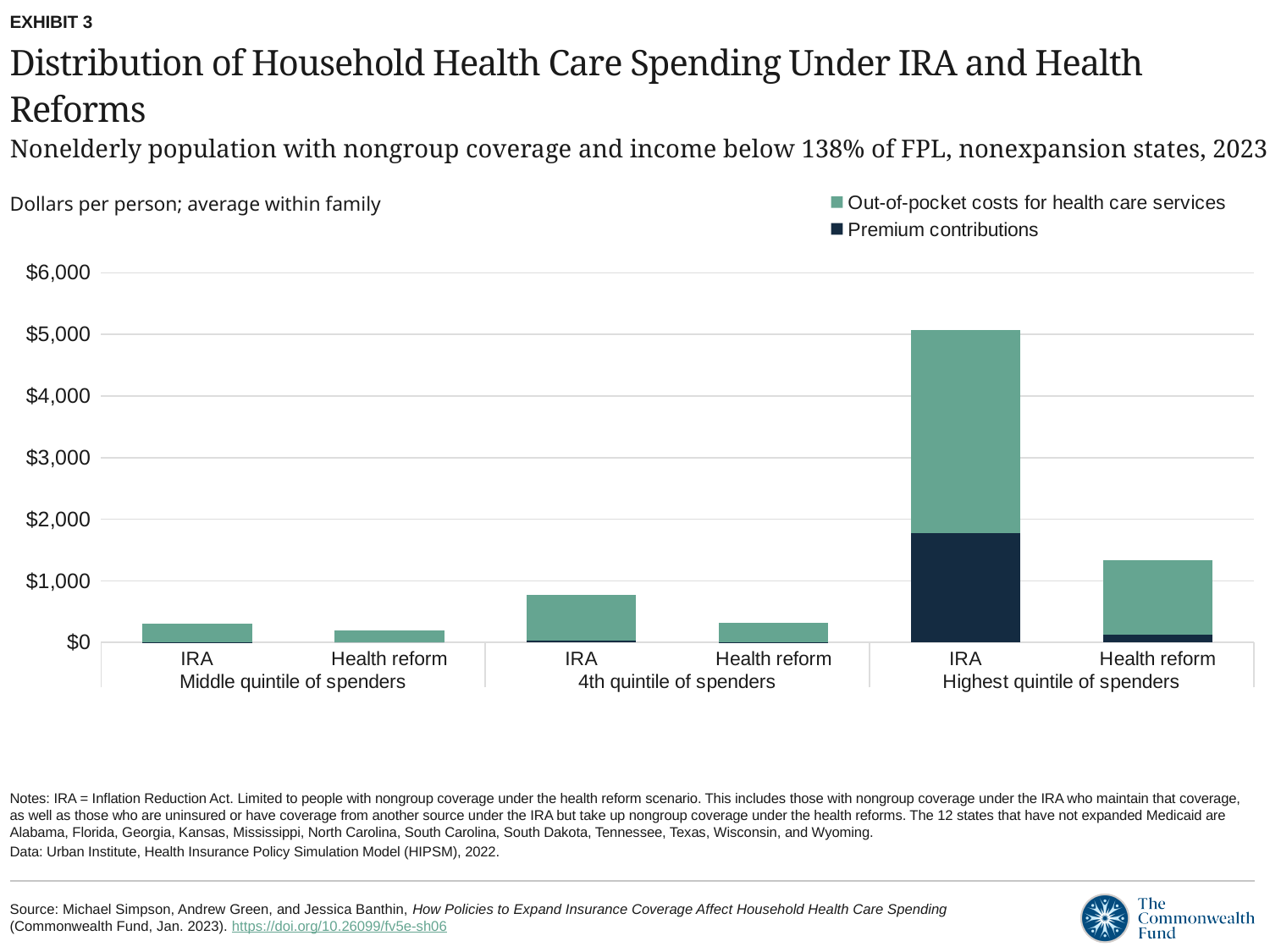
What kind of chart is shown on the slide? Bar chart Is the total value for IRA in the 4th quintile of spenders greater or less than $1,000? less In the highest quintile of spenders, which bar is taller: IRA or Health reform? IRA What unit does the chart say the values are measured in? Dollars per person; average within family Which series is shown in the dark navy colour in the legend? Premium contributions Is the total value for Health reform in the highest quintile of spenders greater or less than $1,000? greater How many bars are plotted in the chart? 6 Which bar is the tallest in the chart? IRA, Highest quintile of spenders Is the total value for IRA in the middle quintile of spenders greater or less than $1,000? less In the 4th quintile of spenders, which bar is taller: IRA or Health reform? IRA How many series does the legend list? 2